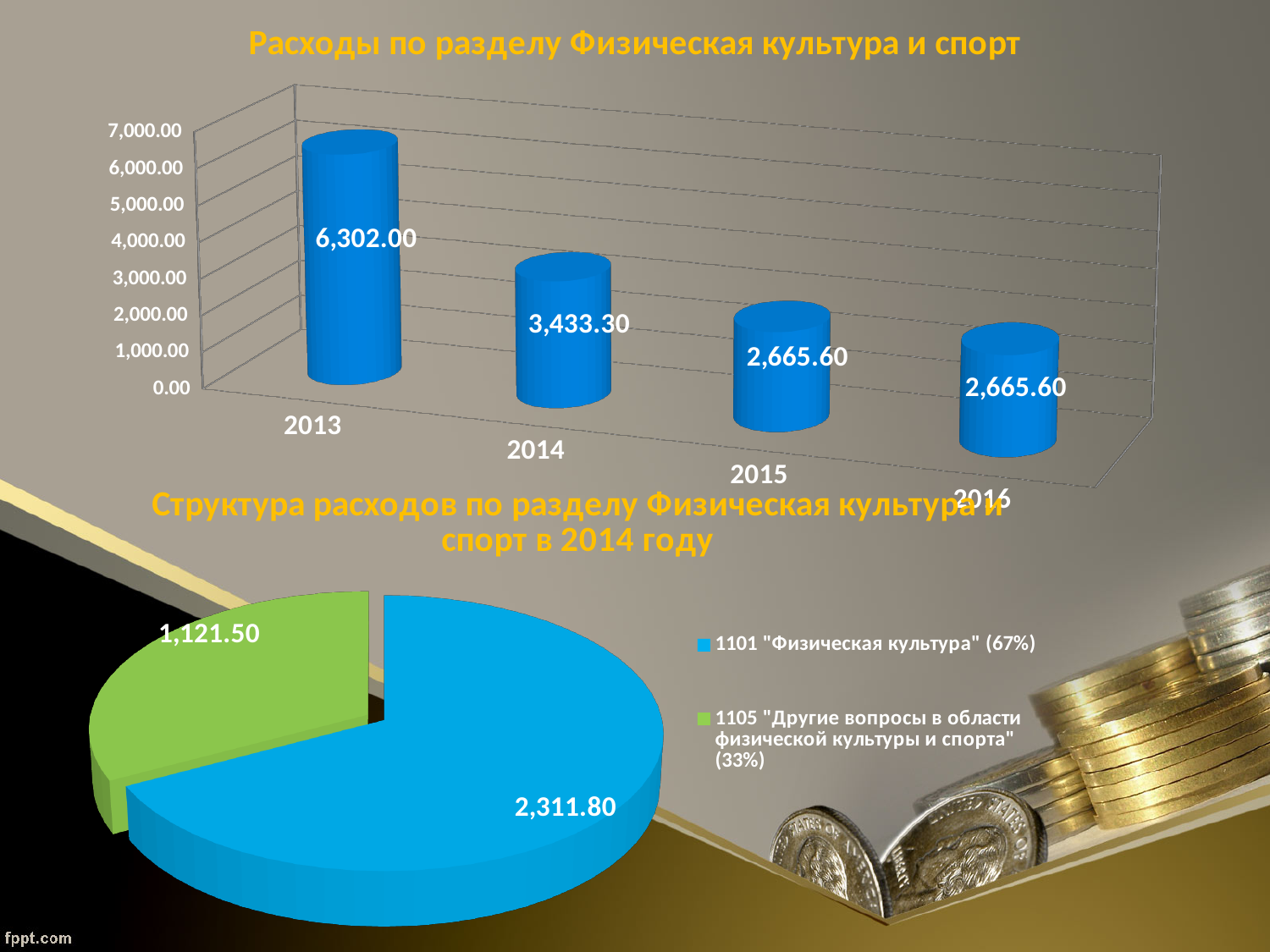
In the bar chart 'Расходы по разделу Физическая культура и спорт', what is the value for 2016? 2,665.60 In the pie chart 'Структура расходов по разделу Физическая культура и спорт в 2014 году', what colour is the slice for 1101 "Физическая культура"? Blue In the pie chart 'Структура расходов по разделу Физическая культура и спорт в 2014 году', what share does 1105 "Другие вопросы в области физической культуры и спорта" have? 33% What kind of chart is the top chart 'Расходы по разделу Физическая культура и спорт'? Bar chart In the bar chart 'Расходы по разделу Физическая культура и спорт', what is the value for 2014? 3,433.30 In the pie chart 'Структура расходов по разделу Физическая культура и спорт в 2014 году', what is the value for 1101 "Физическая культура"? 2,311.80 In the bar chart 'Расходы по разделу Физическая культура и спорт', which is larger, the value for 2014 or the value for 2015? 2014 In the bar chart 'Расходы по разделу Физическая культура и спорт', what is the value for 2013? 6,302.00 In the bar chart 'Расходы по разделу Физическая культура и спорт', do the values generally rise or fall from 2013 to 2016? Fall In the bar chart 'Расходы по разделу Физическая культура и спорт', how many years are shown? 4 In the bar chart 'Расходы по разделу Физическая культура и спорт', which year has the highest value? 2013 In the bar chart 'Расходы по разделу Физическая культура и спорт', what is the difference between the values for 2013 and 2014? 2,868.70